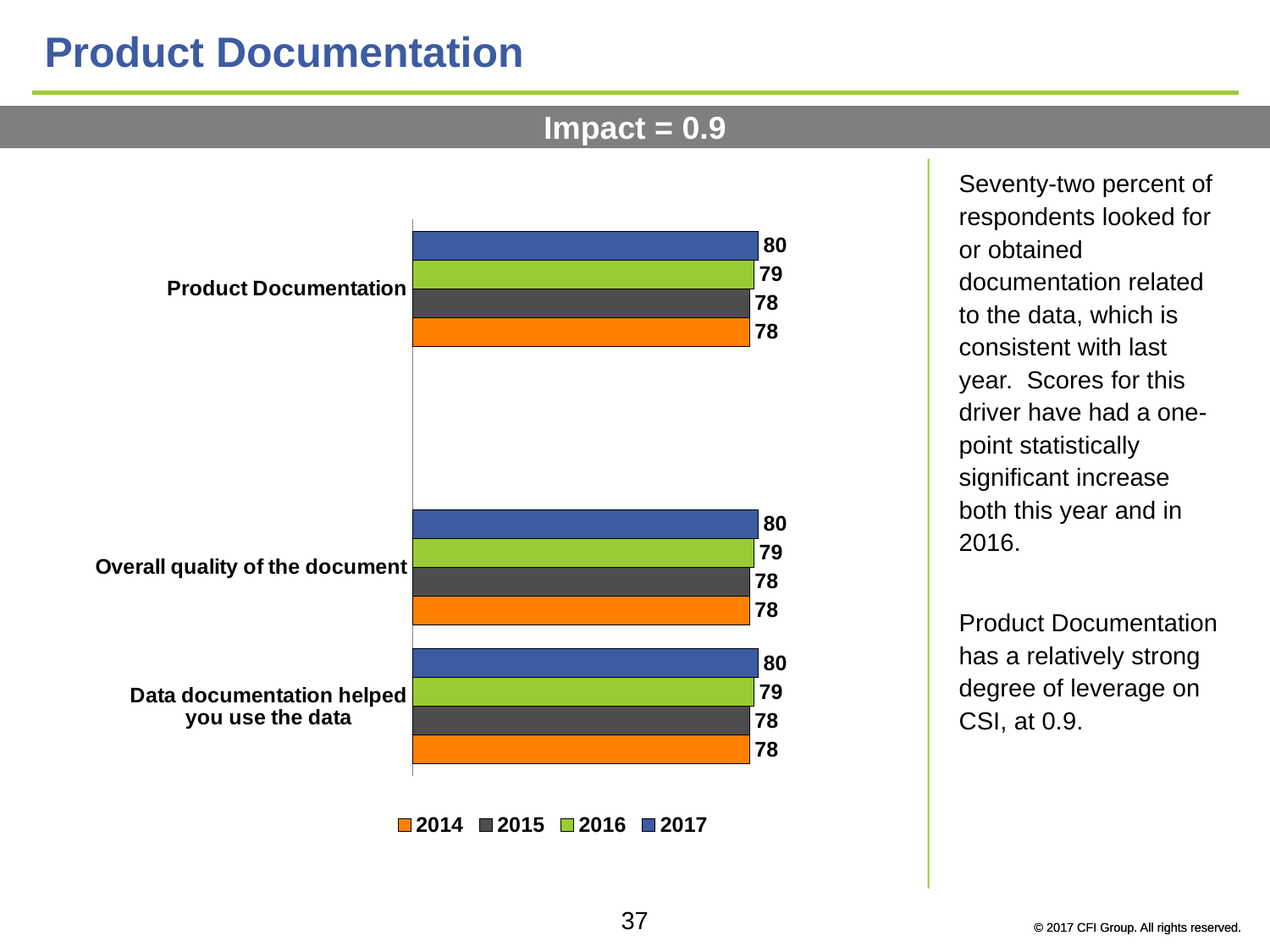
What is the 2017 value for Product Documentation? 80 Which year has the highest value for Overall quality of the document? 2017 What colour represents 2014 in the legend? Orange Do the values for Overall quality of the document rise or fall from 2014 to 2017? Rise How many series does the legend list? 4 What is the difference between the 2017 and 2014 values for Data documentation helped you use the data? 2 What is the 2015 value for Product Documentation? 78 What is the 2014 value for Overall quality of the document? 78 What is the 2016 value for Data documentation helped you use the data? 79 What kind of chart is shown on the slide? Bar chart Which is larger for Product Documentation, the 2016 value or the 2015 value? 2016 How many categories are shown on the chart? 3